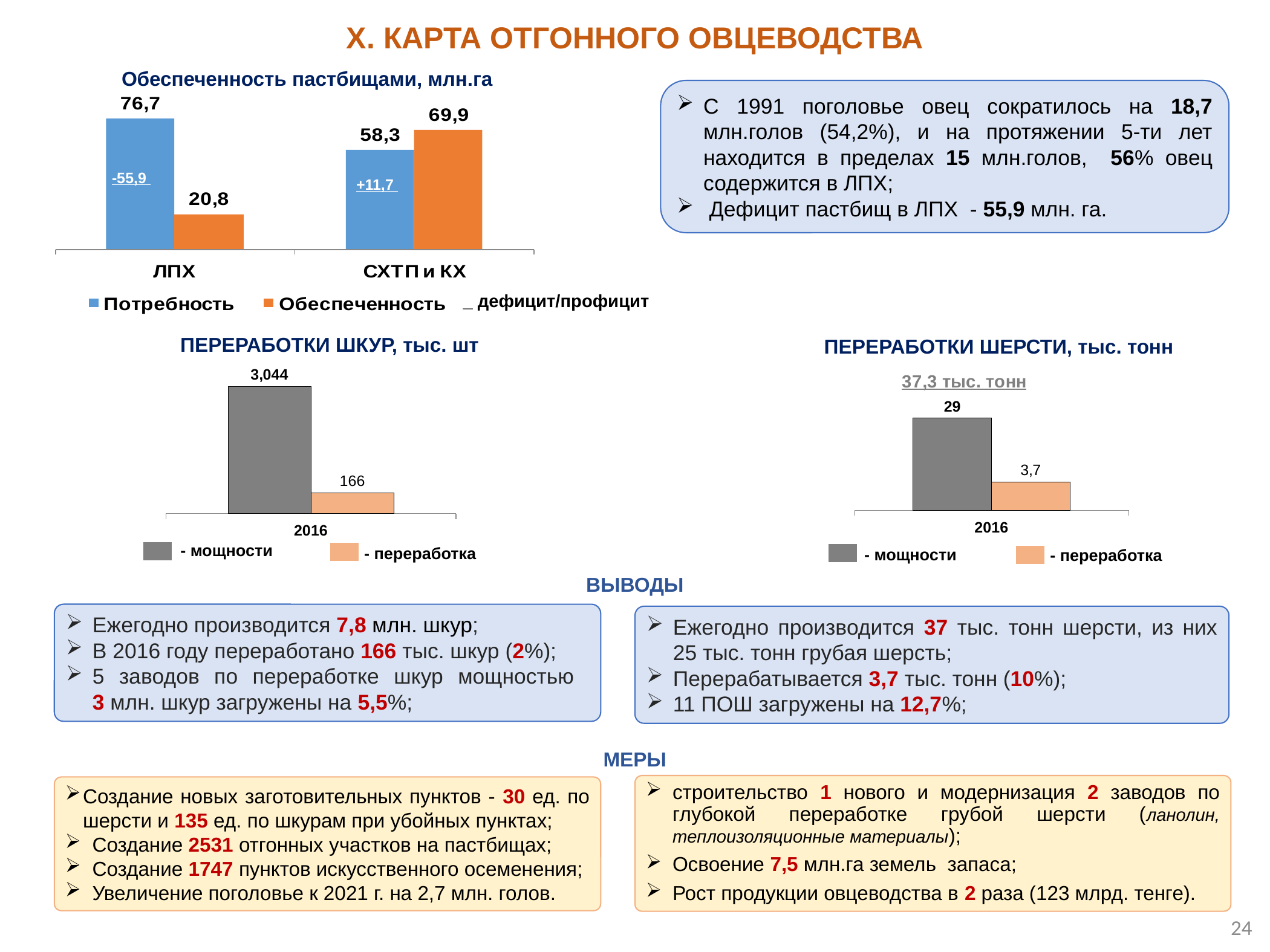
What type of chart is 'ПЕРЕРАБОТКИ ШКУР, тыс. шт'? bar chart In the chart 'Обеспеченность пастбищами, млн.га', what is the value of Обеспеченность for СХТП и КХ? 69,9 In the chart 'Обеспеченность пастбищами, млн.га', how many entries does the legend list? 3 In the chart 'Обеспеченность пастбищами, млн.га', what is the difference between Потребность and Обеспеченность for СХТП и КХ? 11,6 In the chart 'ПЕРЕРАБОТКИ ШЕРСТИ, тыс. тонн', what is the value for переработка in 2016? 3,7 In the chart 'ПЕРЕРАБОТКИ ШКУР, тыс. шт', what is the value for переработка in 2016? 166 In the chart 'Обеспеченность пастбищами, млн.га', which is larger for ЛПХ: Потребность or Обеспеченность? Потребность In the chart 'ПЕРЕРАБОТКИ ШЕРСТИ, тыс. тонн', what is the difference between мощности and переработка in 2016? 25,3 In the chart 'ПЕРЕРАБОТКИ ШКУР, тыс. шт', what is the value for мощности in 2016? 3,044 In the chart 'Обеспеченность пастбищами, млн.га', what is the value of Потребность for ЛПХ? 76,7 In the chart 'Обеспеченность пастбищами, млн.га', how many categories are shown on the x axis? 2 In the chart 'Обеспеченность пастбищами, млн.га', what deficit/surplus value is shown for ЛПХ? -55,9